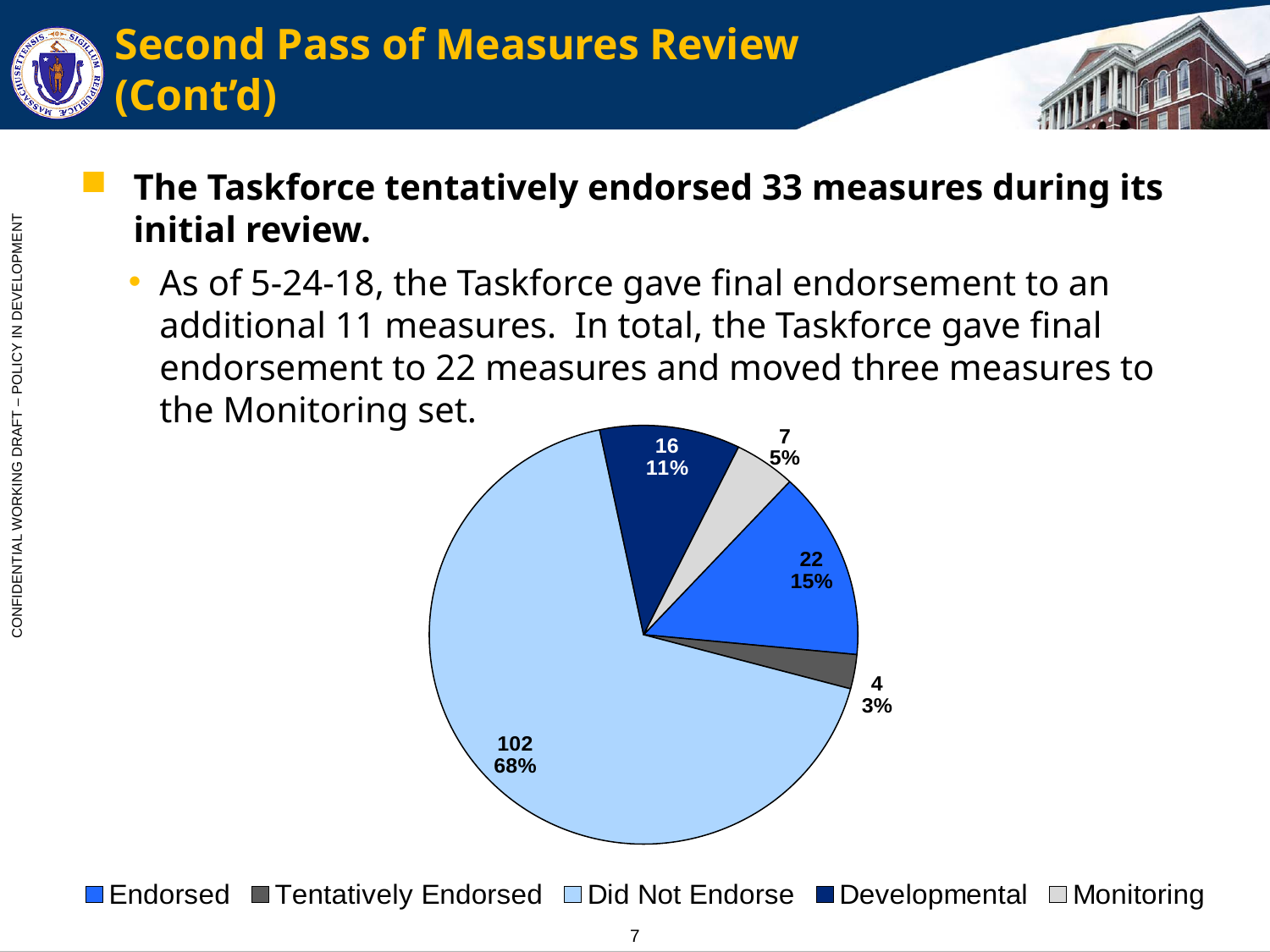
Which category has the largest slice in the pie chart? Did Not Endorse What share of the pie does Tentatively Endorsed represent? 3% What is the value for Endorsed in the pie chart? 22 What share of the pie does Did Not Endorse represent? 68% What is the value for Monitoring in the pie chart? 7 What type of chart is shown on the slide? Pie chart What is the value for Did Not Endorse in the pie chart? 102 Which category has the smallest slice in the pie chart? Tentatively Endorsed What is the value for Developmental in the pie chart? 16 How many slices does the pie chart have? 5 What is the difference between the Endorsed value and the Developmental value in the pie chart? 6 How many entries does the legend of the pie chart list? 5